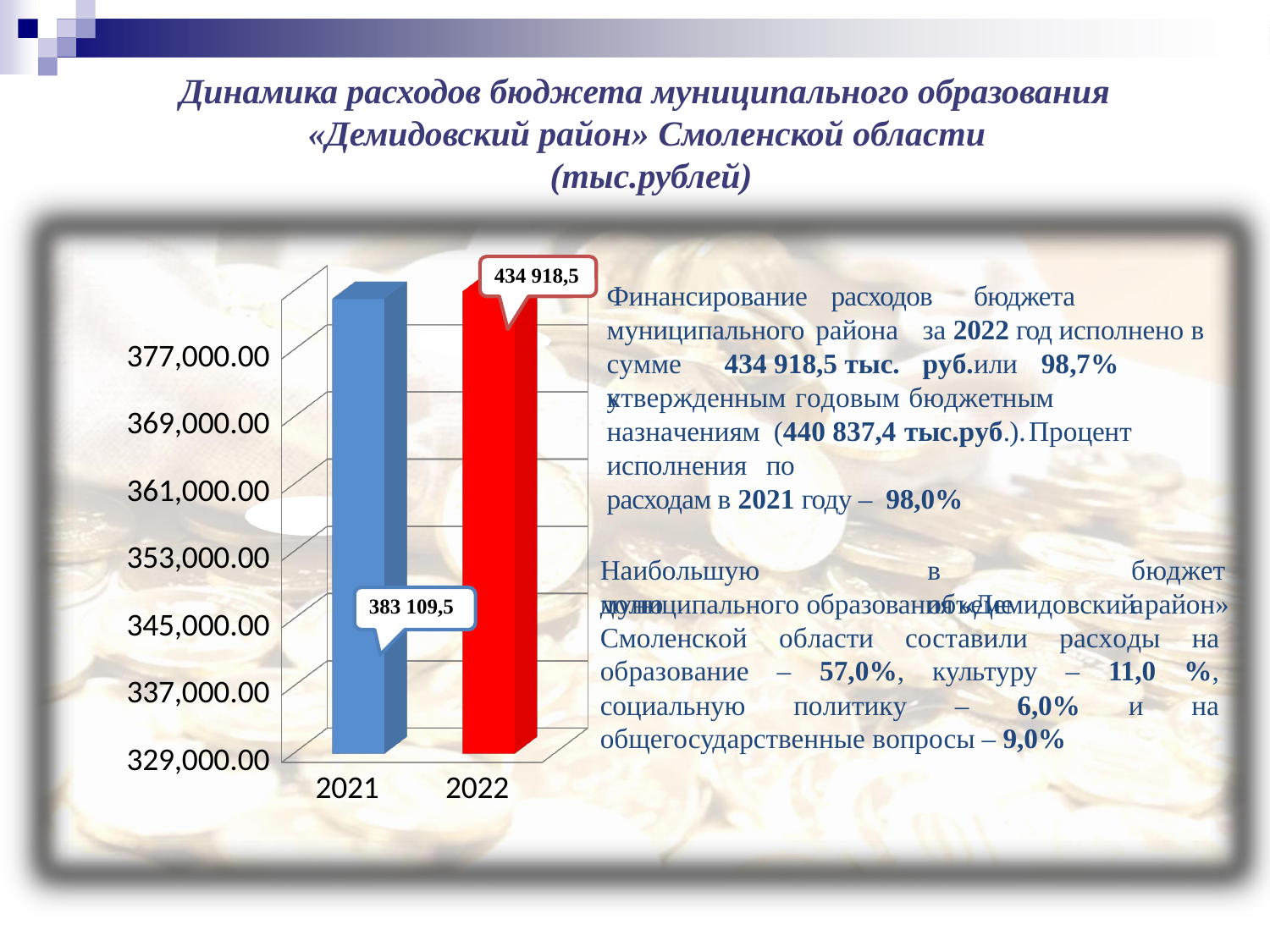
Is the value for 2021 greater or less than 377,000.00? greater Which is larger, the value for 2021 or the value for 2022? 2022 What unit is stated in the chart title? тыс.рублей Do the values rise or fall from 2021 to 2022? Rise Which year has the highest value on the chart? 2022 How many years (categories) are shown on the chart? 2 What colour is the bar for 2022? Red What is the value for 2021 on the chart? 383 109,5 What is the value for 2022 on the chart? 434 918,5 Which year has the lowest value on the chart? 2021 What is the difference between the values for 2022 and 2021? 51 809,0 What kind of chart is shown on the slide? Bar chart